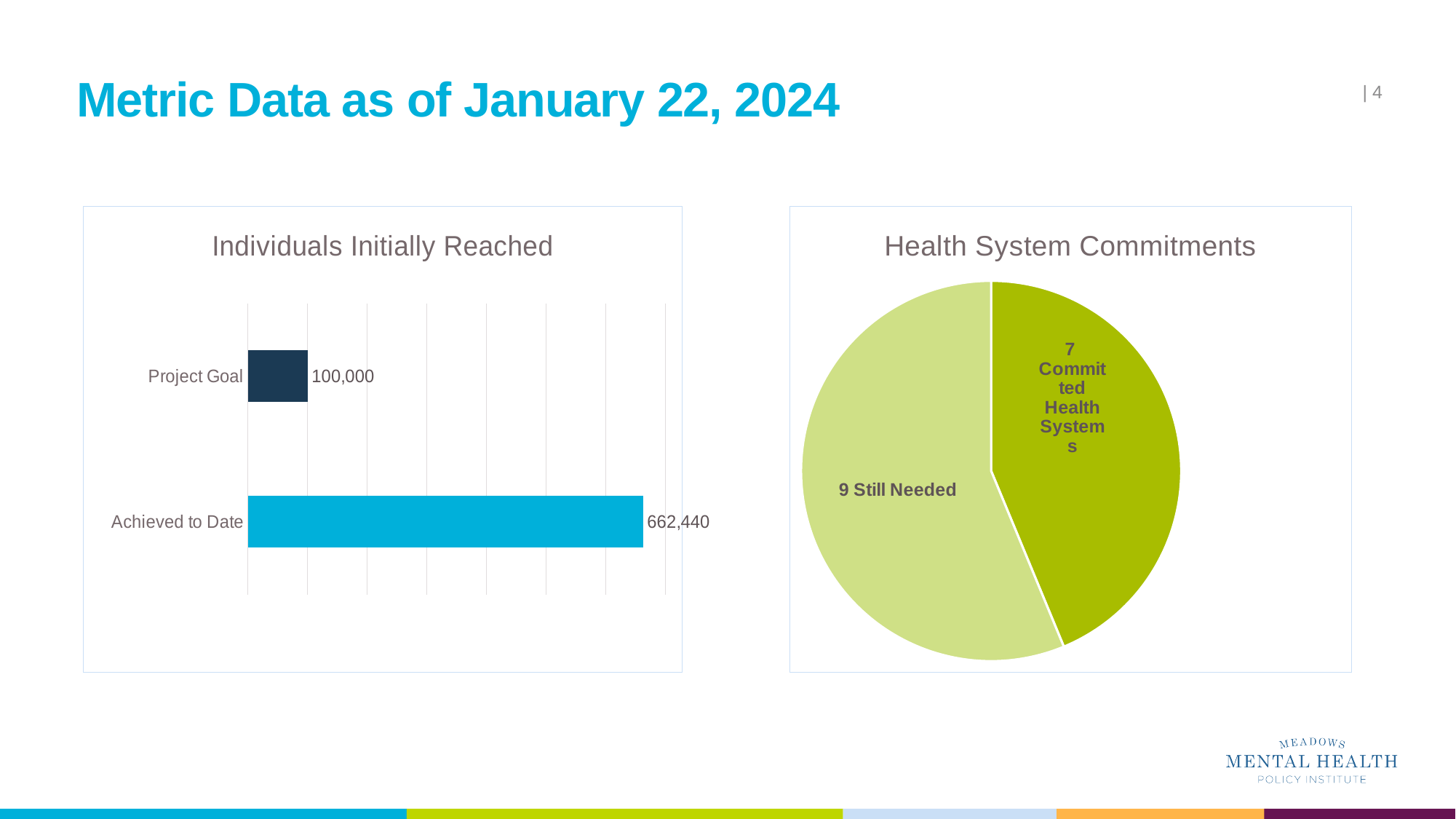
In the 'Health System Commitments' pie chart, how many health systems are committed? 7 In the 'Individuals Initially Reached' chart, what is the difference between Achieved to Date and Project Goal? 562,440 In the 'Individuals Initially Reached' chart, how many categories are shown? 2 In the 'Individuals Initially Reached' chart, which category has the higher value? Achieved to Date In the 'Individuals Initially Reached' chart, which category has the lower value? Project Goal What kind of chart is 'Individuals Initially Reached'? Bar chart In the 'Health System Commitments' pie chart, how many health systems are still needed? 9 In the 'Individuals Initially Reached' chart, what is the value for Project Goal? 100,000 What kind of chart is 'Health System Commitments'? Pie chart In the 'Health System Commitments' pie chart, which slice is larger: Committed Health Systems or Still Needed? Still Needed In the 'Individuals Initially Reached' chart, what is the value for Achieved to Date? 662,440 In the 'Health System Commitments' pie chart, what is the total number of health systems represented by both slices? 16